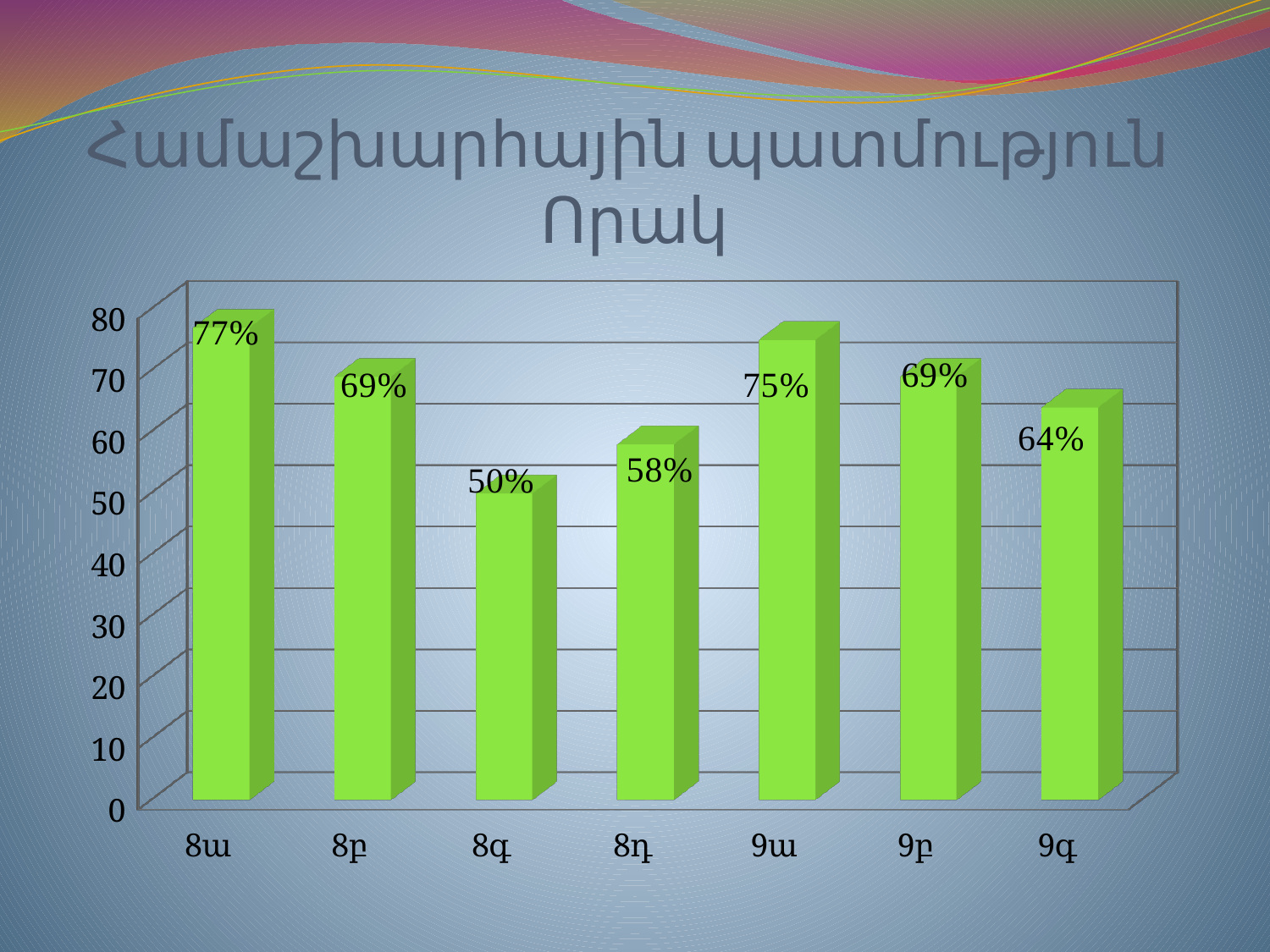
Is the value for 9բ greater or less than 60? greater Which is larger, the value for 8դ or the value for 9գ? 9գ What is the difference between the values for 8ա and 8գ? 27% Which category has the highest value? 8ա What is the value for 8ա? 77% What colour are the bars in the chart? green What is the value for 8գ? 50% What is the value for 9գ? 64% Which category has the lowest value? 8գ What kind of chart is shown on the slide? bar chart What is the value for 9ա? 75% How many categories are shown on the x axis? 7